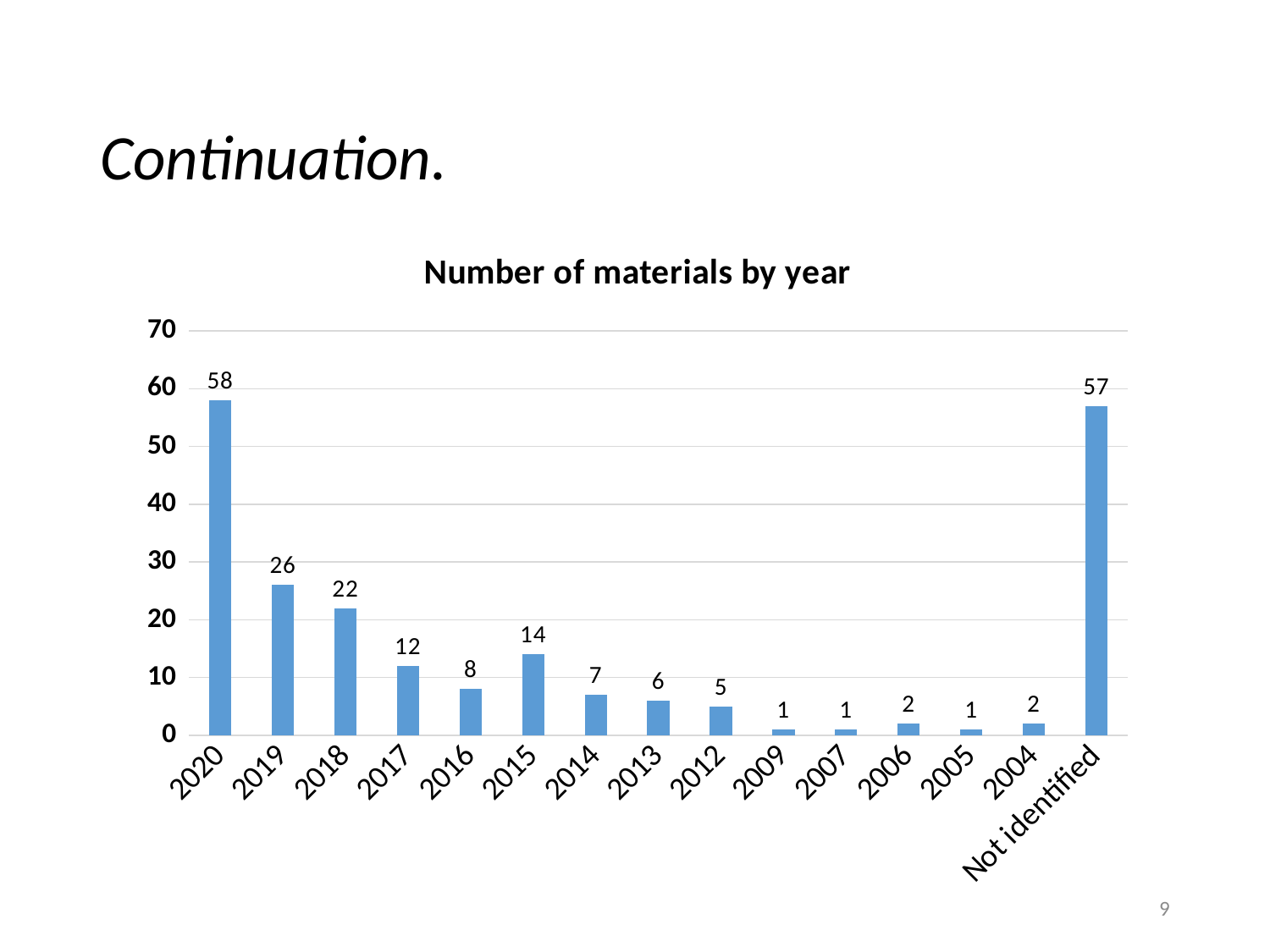
What is the number of materials for 2017? 12 What is the title of the chart? Number of materials by year What kind of chart is shown on the slide? Bar chart Is the value for 2019 greater or less than 20? greater Do the values generally rise or fall from 2020 to 2012 along the x axis? Fall What is the difference between the values for 2020 and 'Not identified'? 1 What is the value shown for the 'Not identified' category? 57 What is the number of materials for 2020? 58 Which is larger, the value for 2015 or the value for 2016? 2015 How many categories are shown on the x axis? 15 What is the difference between the values for 2019 and 2018? 4 Which category has the highest number of materials? 2020